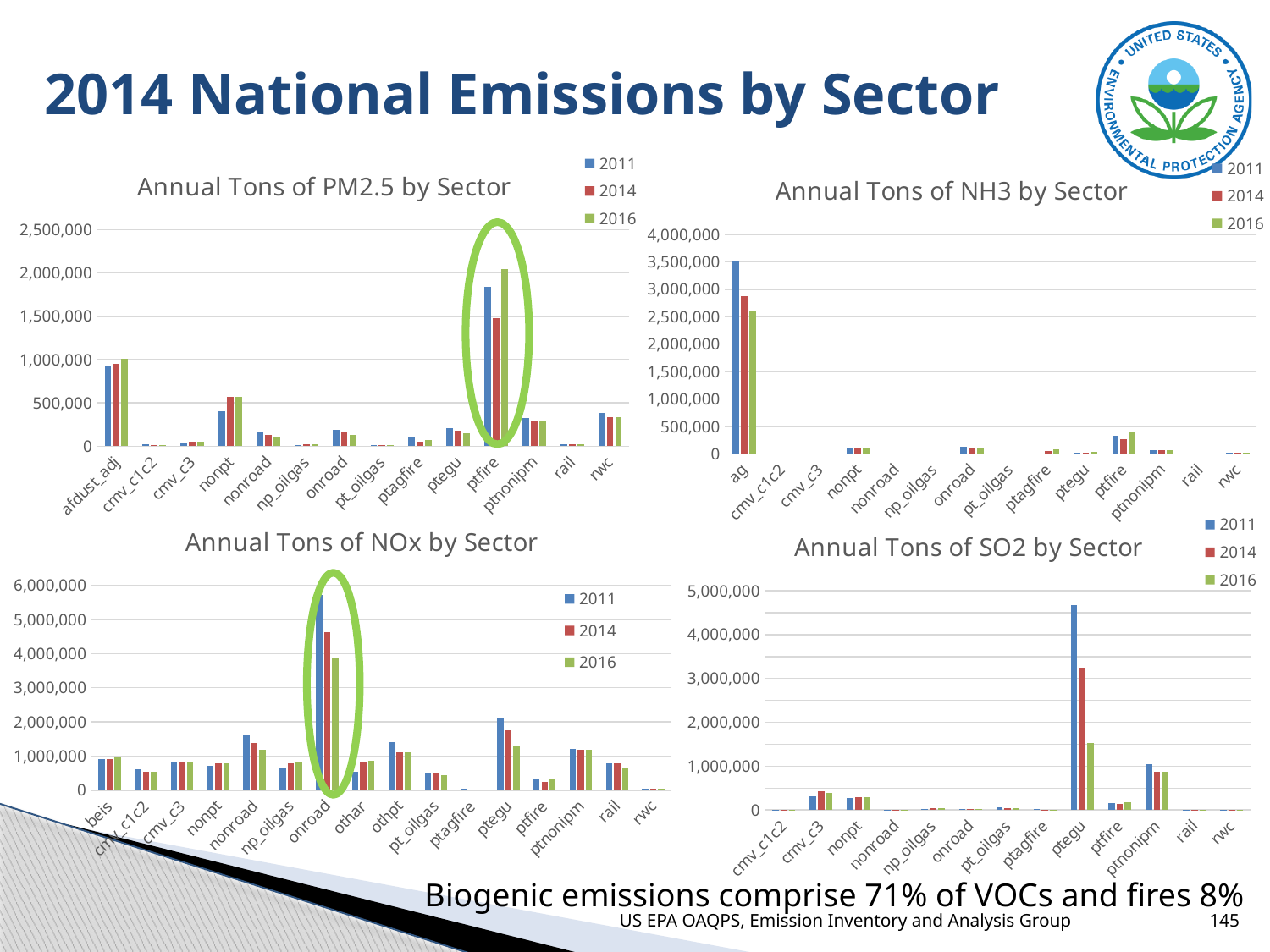
In the 'Annual Tons of SO2 by Sector' chart, is the 2011 value for ptegu greater or less than 4,000,000? greater How many sectors are shown on the x axis of the 'Annual Tons of NOx by Sector' chart? 16 In the 'Annual Tons of NOx by Sector' chart, which sector has the highest emissions? onroad In the 'Annual Tons of PM2.5 by Sector' chart, which sector's bars are circled in green? ptfire In the 'Annual Tons of NH3 by Sector' chart, which is larger for ag: the 2011 value or the 2016 value? 2011 In the 'Annual Tons of NH3 by Sector' chart, is the 2011 value for ag greater or less than 3,000,000? greater In the 'Annual Tons of NH3 by Sector' chart, which sector has the highest emissions? ag How many series does the legend of the 'Annual Tons of NOx by Sector' chart list? 3 In the 'Annual Tons of PM2.5 by Sector' chart, which sector has the highest emissions? ptfire In the 'Annual Tons of SO2 by Sector' chart, do the ptegu values rise or fall from 2011 to 2016? fall What kind of chart is 'Annual Tons of SO2 by Sector'? bar chart